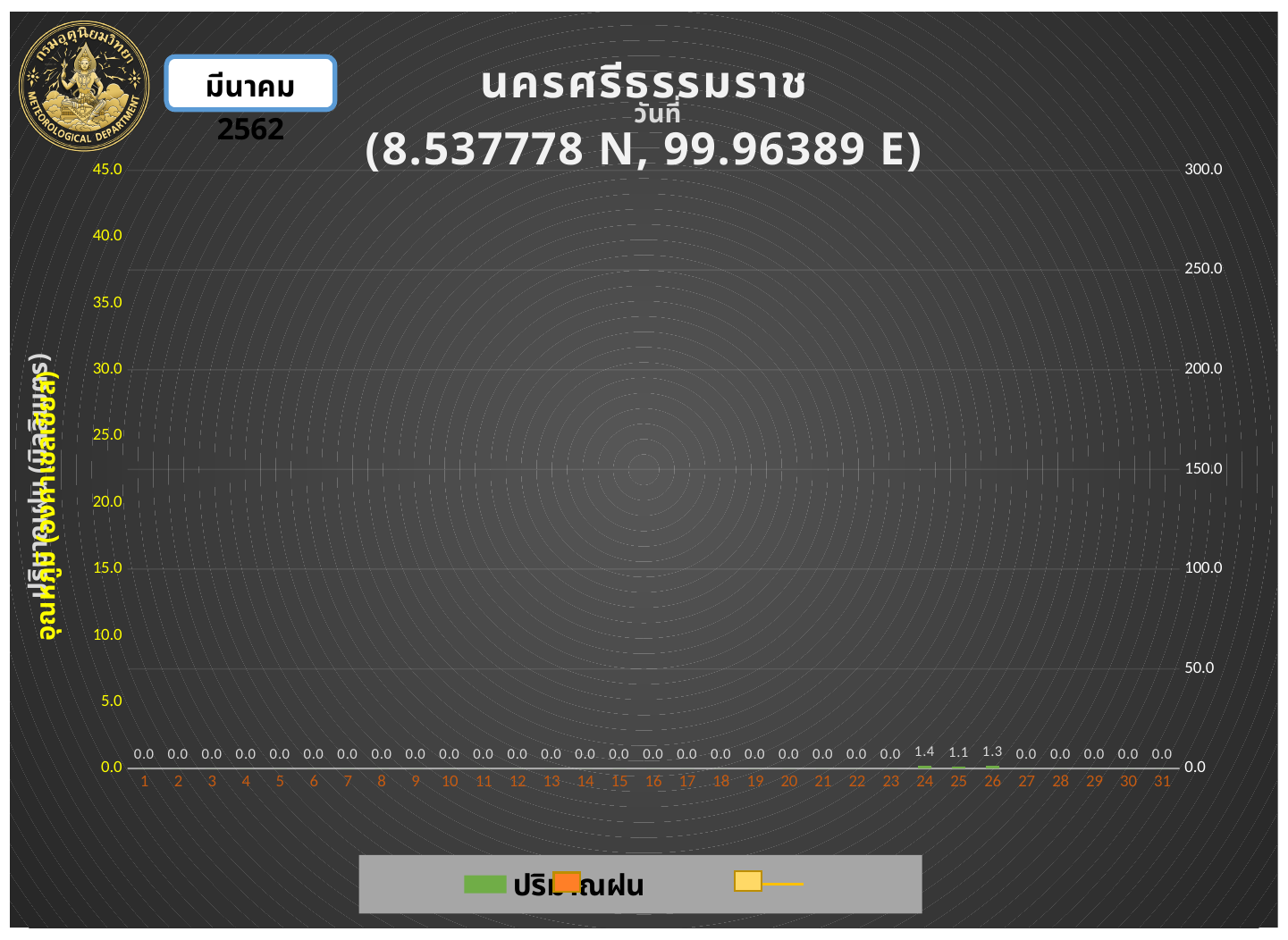
What is the rainfall value shown for day 10? 0.0 What is the rainfall value shown for day 24? 1.4 What is the highest value shown on the right-hand vertical axis? 300.0 What is the difference between the rainfall values for day 26 and day 25? 0.2 What colour is used in the legend for ปริมาณฝน? green What kind of chart is used to show the rainfall values? bar chart Which day has the highest rainfall value on the chart? 24 Which day has the larger rainfall value, day 24 or day 26? 24 What is the rainfall value shown for day 25? 1.1 What is the difference between the rainfall values for day 24 and day 25? 0.3 What is the rainfall value shown for day 26? 1.3 How many days are shown along the x axis of the chart? 31